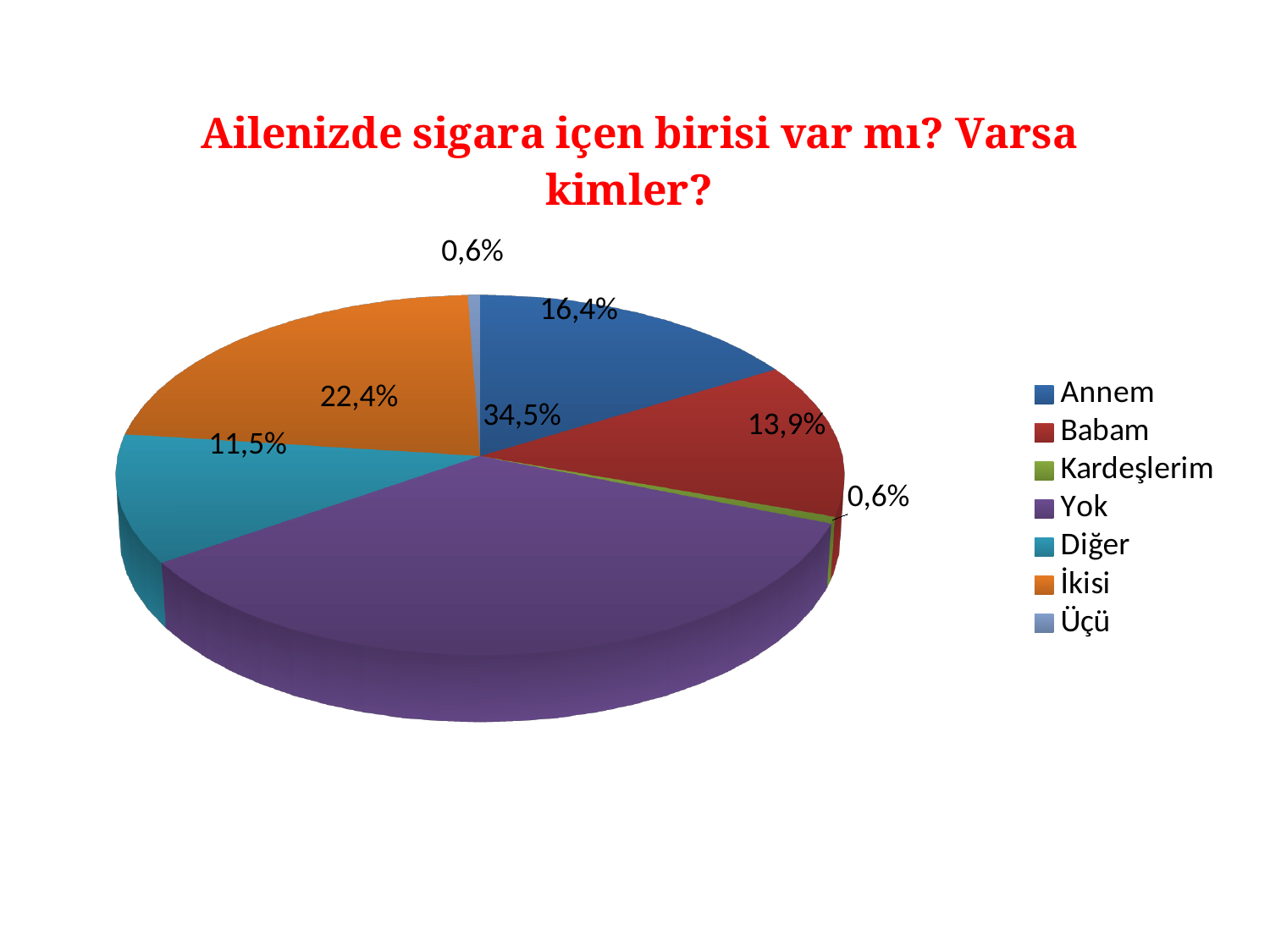
What percentage is shown for Yok? 34,5% What percentage is shown for İkisi? 22,4% What percentage is shown for Babam? 13,9% Which is larger, the share for Annem or the share for Babam? Annem What is the difference between the shares for İkisi and Diğer? 10,9% Which colour represents Yok in the chart? purple What percentage is shown for Diğer? 11,5% What is the title of the chart? Ailenizde sigara içen birisi var mı? Varsa kimler? How many categories does the legend list? 7 Which category has the largest share of the pie? Yok What percentage is shown for Annem? 16,4% What kind of chart is shown on the slide? pie chart